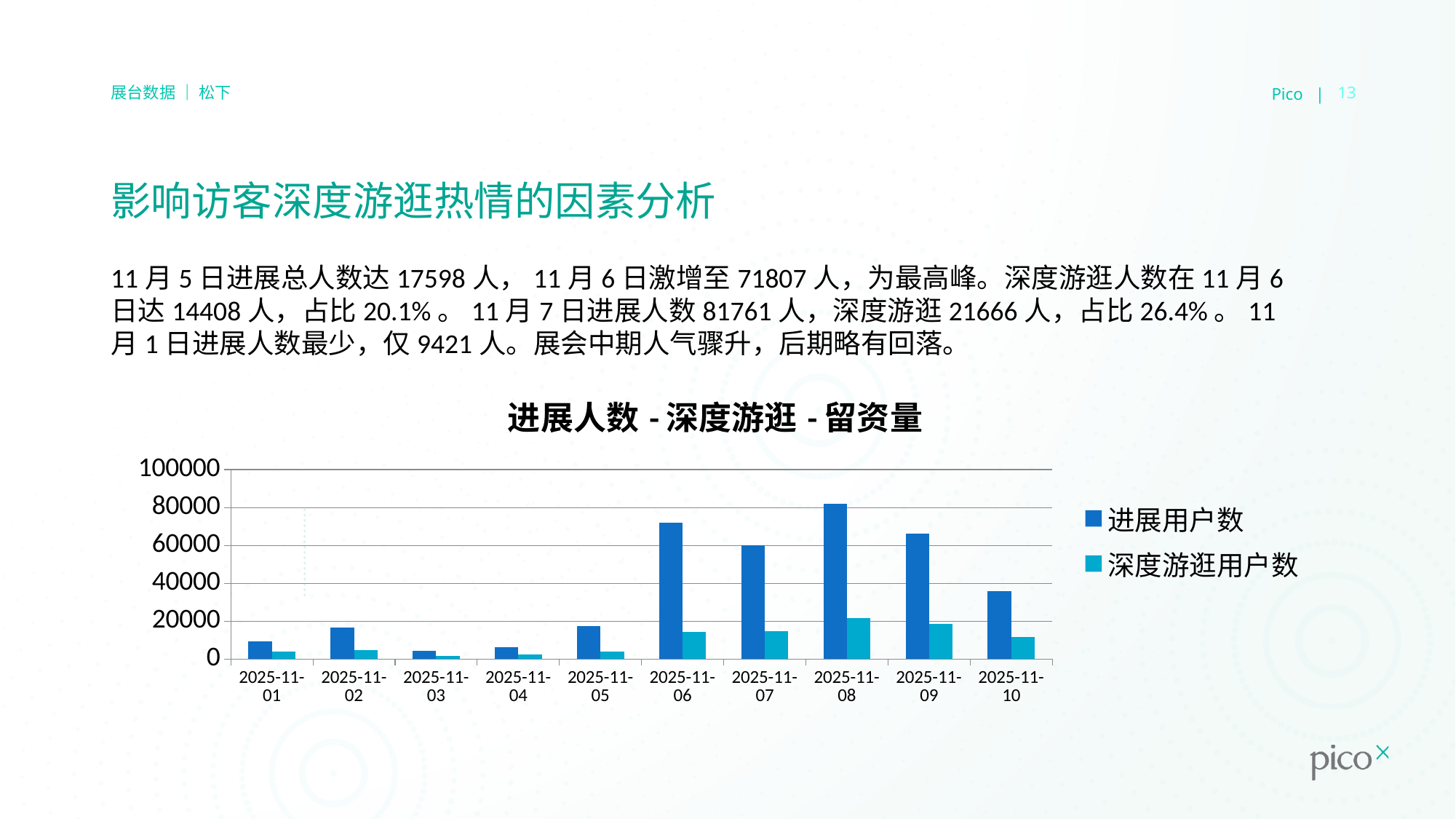
Do the 进展用户数 values rise or fall from 2025-11-08 to 2025-11-10? fall Is the 进展用户数 value for 2025-11-06 greater or less than 60000? greater Which date has the larger 进展用户数 value, 2025-11-06 or 2025-11-07? 2025-11-06 On which date is the 深度游逛用户数 bar the highest? 2025-11-08 On which date is the 进展用户数 bar the highest? 2025-11-08 How many dates are shown on the x axis of the chart? 10 Which date has the larger 进展用户数 value, 2025-11-09 or 2025-11-10? 2025-11-09 What kind of chart is shown on the slide? Bar chart What is the title of the chart? 进展人数 - 深度游逛 - 留资量 Is the 进展用户数 value for 2025-11-10 greater or less than 40000? less How many series does the chart legend list? 2